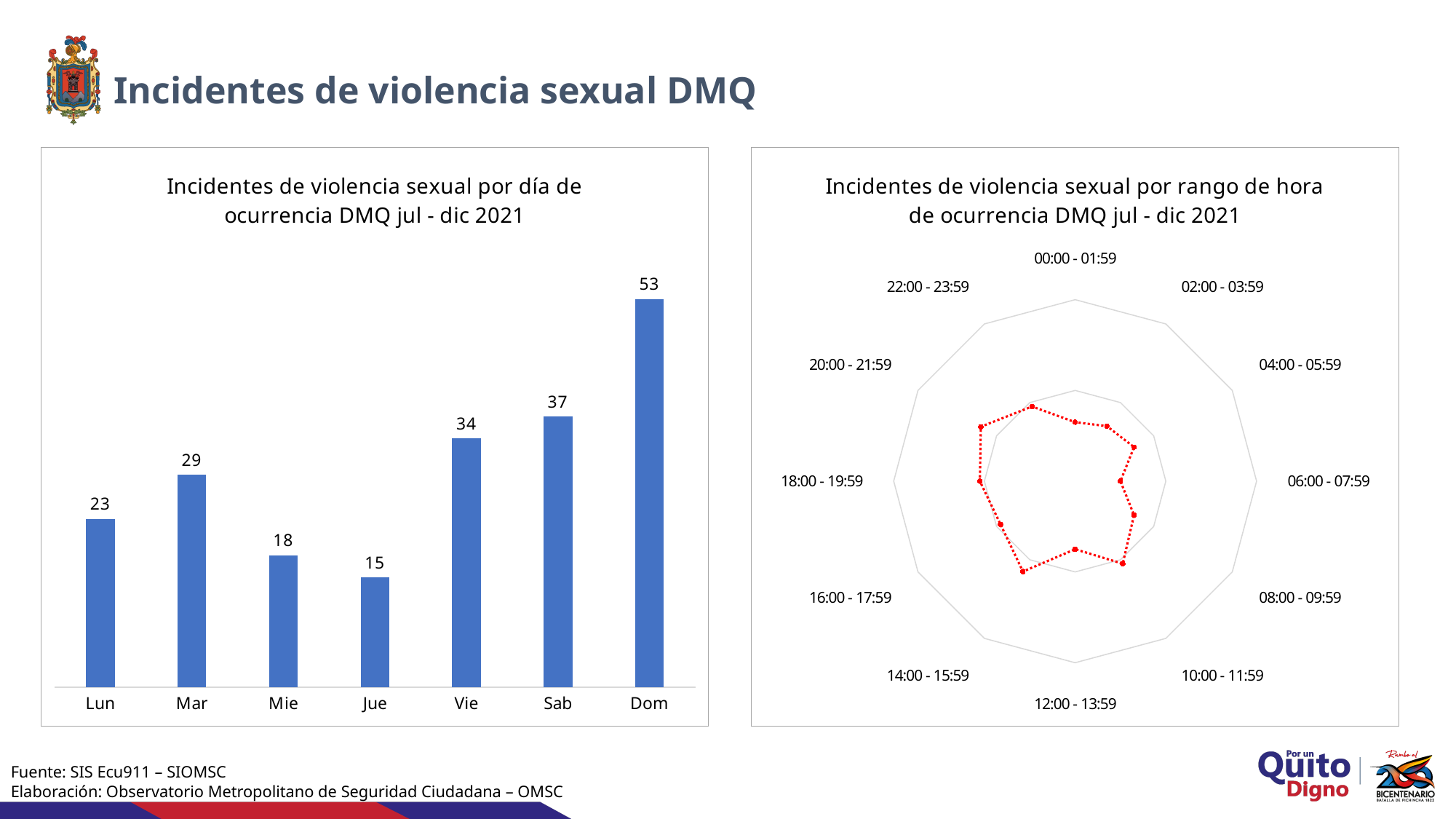
In the chart 'Incidentes de violencia sexual por día de ocurrencia DMQ jul - dic 2021', do the values rise or fall from Jue to Dom? Rise In the chart 'Incidentes de violencia sexual por día de ocurrencia DMQ jul - dic 2021', which day has the highest value? Dom In the chart 'Incidentes de violencia sexual por día de ocurrencia DMQ jul - dic 2021', what is the value for Mie? 18 In the chart 'Incidentes de violencia sexual por día de ocurrencia DMQ jul - dic 2021', what is the value for Dom? 53 In the chart 'Incidentes de violencia sexual por día de ocurrencia DMQ jul - dic 2021', which is larger, the value for Mar or the value for Vie? Vie In the chart 'Incidentes de violencia sexual por día de ocurrencia DMQ jul - dic 2021', what is the difference between the values for Lun and Jue? 8 In the chart 'Incidentes de violencia sexual por rango de hora de ocurrencia DMQ jul - dic 2021', how many time ranges are shown? 12 In the chart 'Incidentes de violencia sexual por día de ocurrencia DMQ jul - dic 2021', which day has the lowest value? Jue In the chart 'Incidentes de violencia sexual por día de ocurrencia DMQ jul - dic 2021', how many days are shown on the x axis? 7 What kind of chart is the left chart, 'Incidentes de violencia sexual por día de ocurrencia DMQ jul - dic 2021'? Bar chart What kind of chart is the right chart, 'Incidentes de violencia sexual por rango de hora de ocurrencia DMQ jul - dic 2021'? Radar chart In the chart 'Incidentes de violencia sexual por día de ocurrencia DMQ jul - dic 2021', what is the difference between the values for Dom and Sab? 16